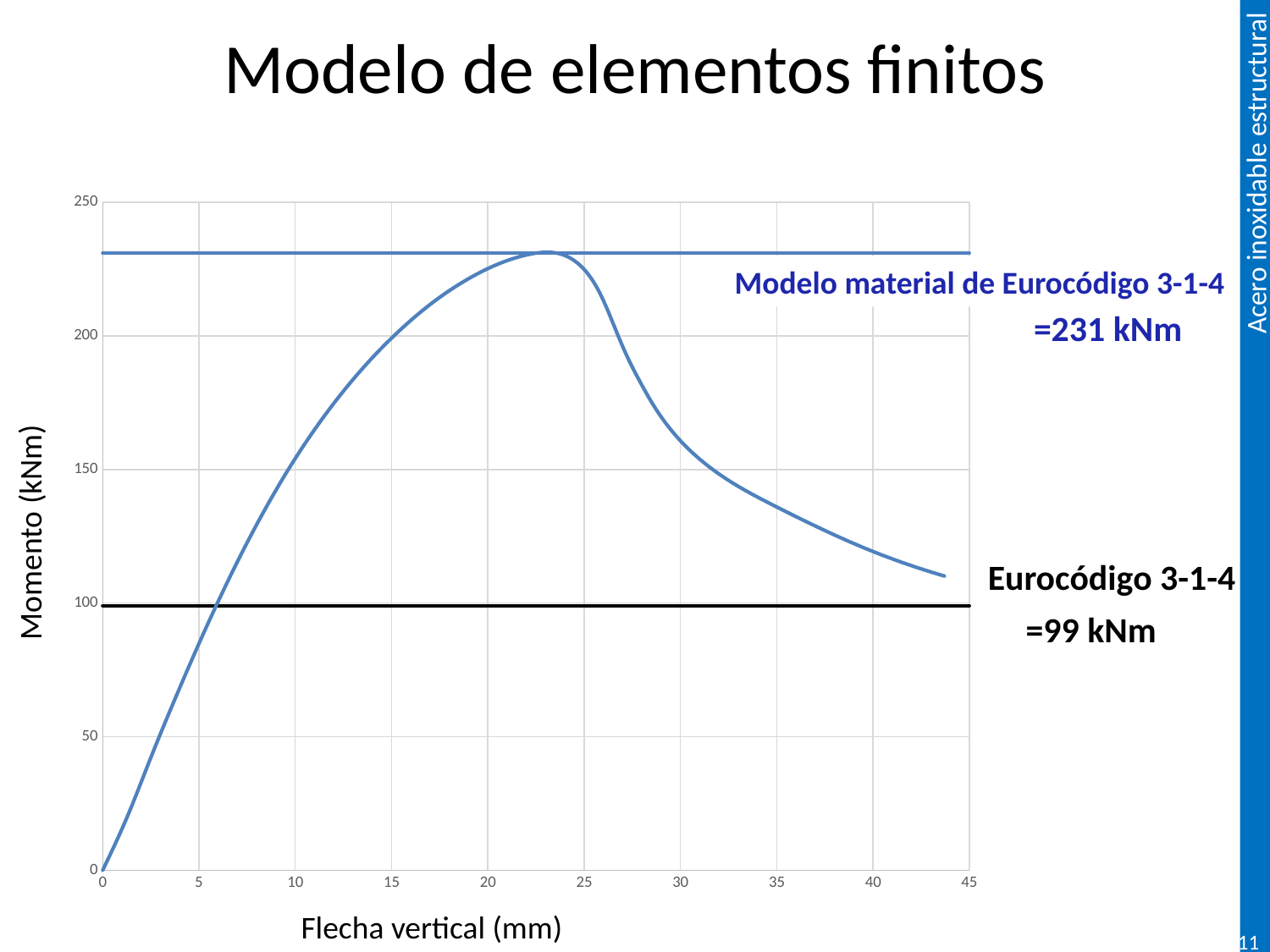
What is the label of the x axis? Flecha vertical (mm) Is the moment on the curve at a vertical deflection of 20 mm greater or less than 200 kNm? greater What is the difference between the 'Modelo material de Eurocódigo 3-1-4' value and the 'Eurocódigo 3-1-4' value? 132 kNm What kind of chart is shown on the slide? line chart What moment value is given for the 'Modelo material de Eurocódigo 3-1-4' reference line? 231 kNm Which reference line is higher, 'Modelo material de Eurocódigo 3-1-4' or 'Eurocódigo 3-1-4'? Modelo material de Eurocódigo 3-1-4 What is the label of the y axis? Momento (kNm) What moment value is given for the 'Eurocódigo 3-1-4' reference line? 99 kNm Is the moment on the curve at a vertical deflection of 40 mm greater or less than 100 kNm? greater Does the curve rise or fall as the vertical deflection increases from 30 to 45 mm? fall Is the moment on the curve at a vertical deflection of 5 mm greater or less than 100 kNm? less Does the curve rise or fall as the vertical deflection increases from 0 to 20 mm? rise